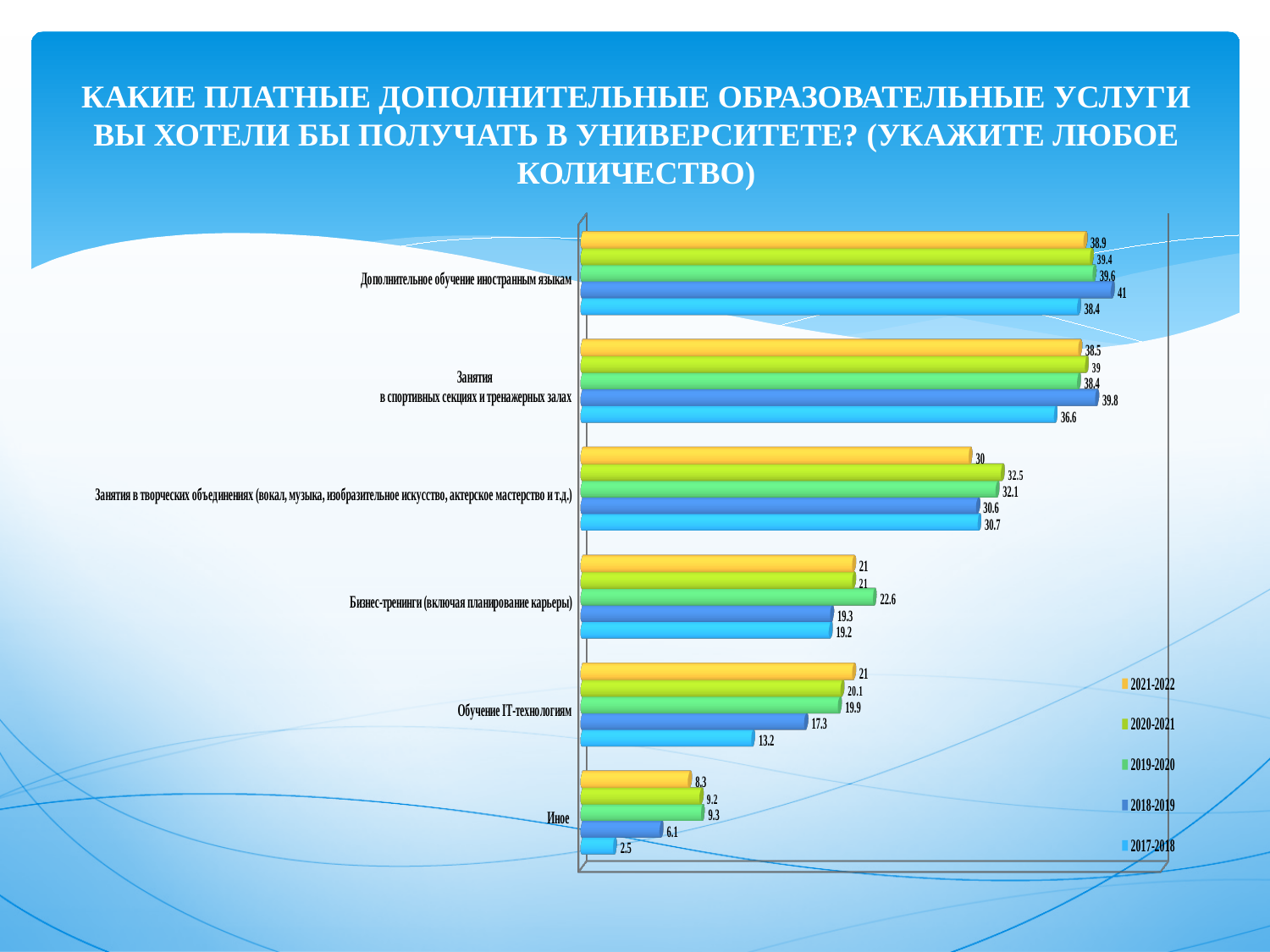
What is the value for 'Дополнительное обучение иностранным языкам' in the 2018-2019 series? 41 Which category has the lowest value in the 2017-2018 series? Иное How many series does the legend list? 5 What is the value for 'Иное' in the 2020-2021 series? 9.2 What is the difference between the 2018-2019 and 2017-2018 values for 'Обучение IT-технологиям'? 4.1 What kind of chart is shown on the slide? Bar chart How many categories are plotted on the chart? 6 Which category has the highest value in the 2021-2022 series? Дополнительное обучение иностранным языкам Which series is listed first in the legend? 2021-2022 What is the value for 'Обучение IT-технологиям' in the 2017-2018 series? 13.2 What is the difference between the 2021-2022 and 2017-2018 values for 'Иное'? 5.8 For 'Бизнес-тренинги (включая планирование карьеры)', which series has the larger value: 2019-2020 or 2018-2019? 2019-2020